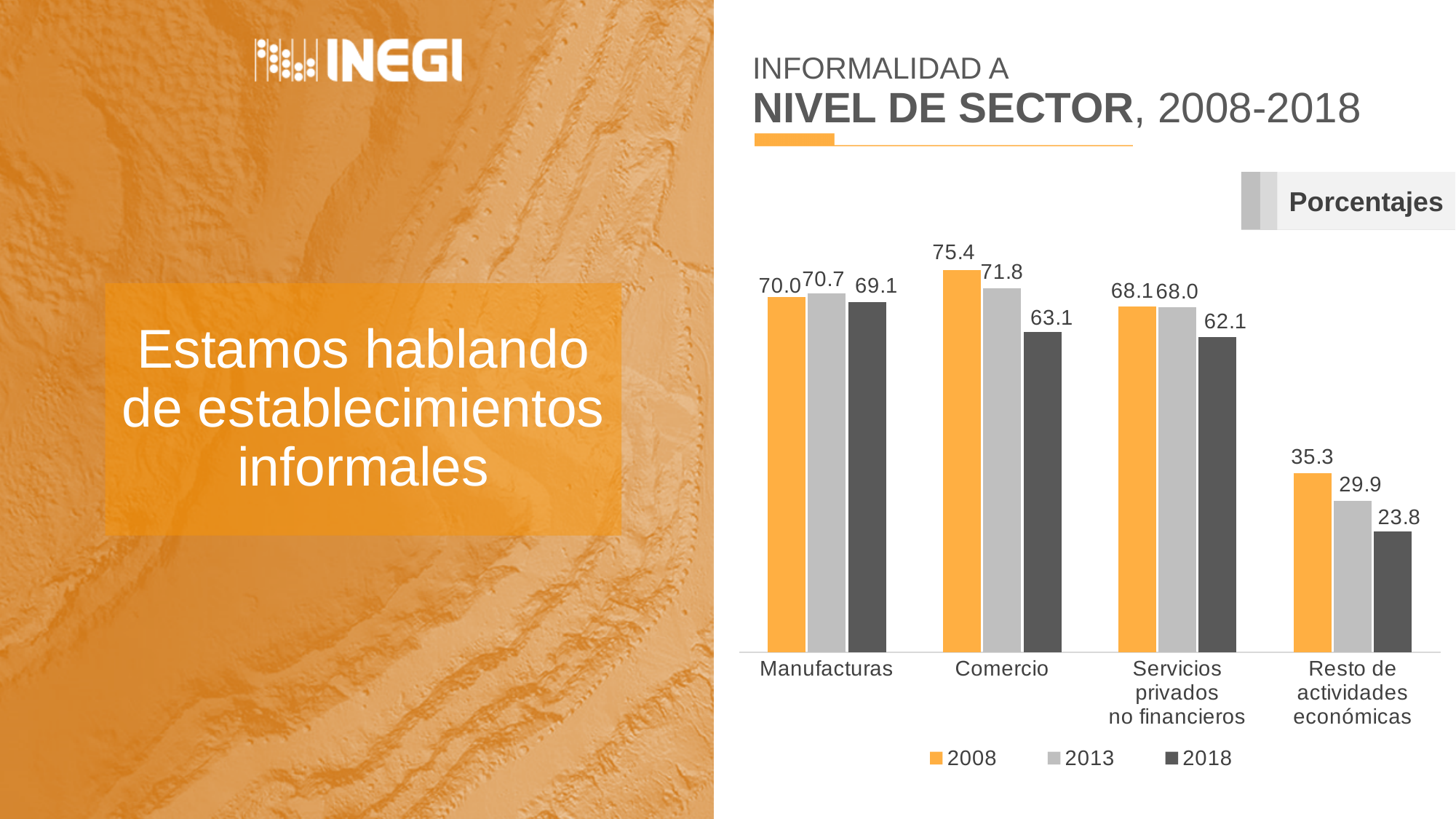
How many series does the legend list? 3 What is the difference between the 2008 and 2018 values for Comercio? 12.3 Which category has the highest value in 2008? Comercio Which category has the lowest value in 2018? Resto de actividades económicas Which is larger: the 2013 value for Manufacturas or the 2013 value for Comercio? Comercio What kind of chart is shown on the slide? Bar chart What is the value for Manufacturas in 2013? 70.7 What is the value for Comercio in 2008? 75.4 Do the values for Resto de actividades económicas rise or fall from 2008 to 2018? Fall What is the value for Resto de actividades económicas in 2018? 23.8 How many categories are shown on the x axis? 4 What is the difference between the 2013 and 2018 values for Servicios privados no financieros? 5.9